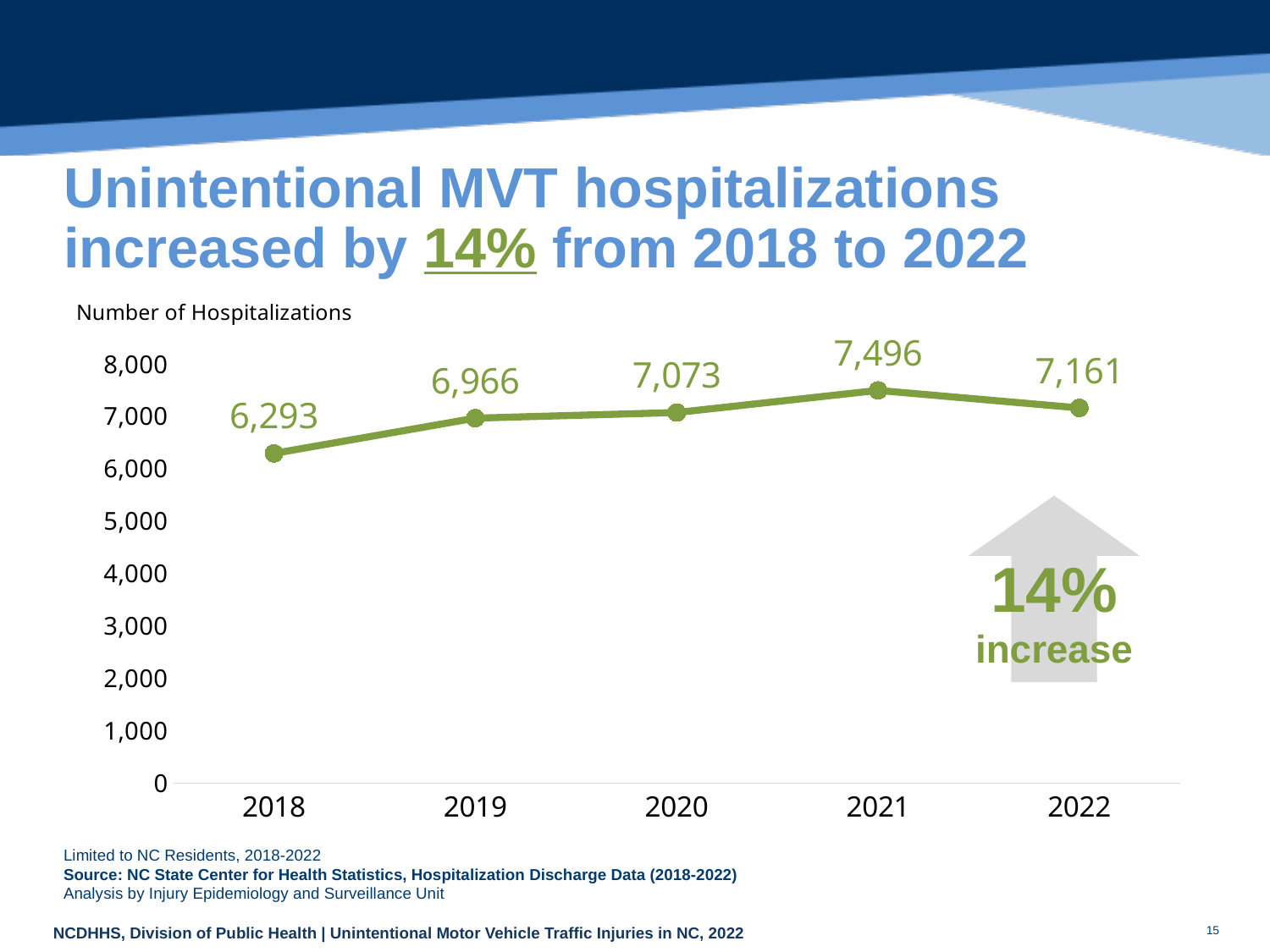
Is the value for 2018 greater or less than 7,000? less What was the number of hospitalizations in 2018? 6,293 What was the number of hospitalizations in 2022? 7,161 What is the difference in hospitalizations between 2018 and 2022? 868 Which year had more hospitalizations, 2019 or 2020? 2020 What percentage increase in hospitalizations from 2018 to 2022 does the slide highlight? 14% How many years are plotted on the chart? 5 What was the number of hospitalizations in 2021? 7,496 Which year had the highest number of hospitalizations? 2021 Which year had the lowest number of hospitalizations? 2018 What is the difference in hospitalizations between 2021 and 2022? 335 What kind of chart is shown on the slide? line chart